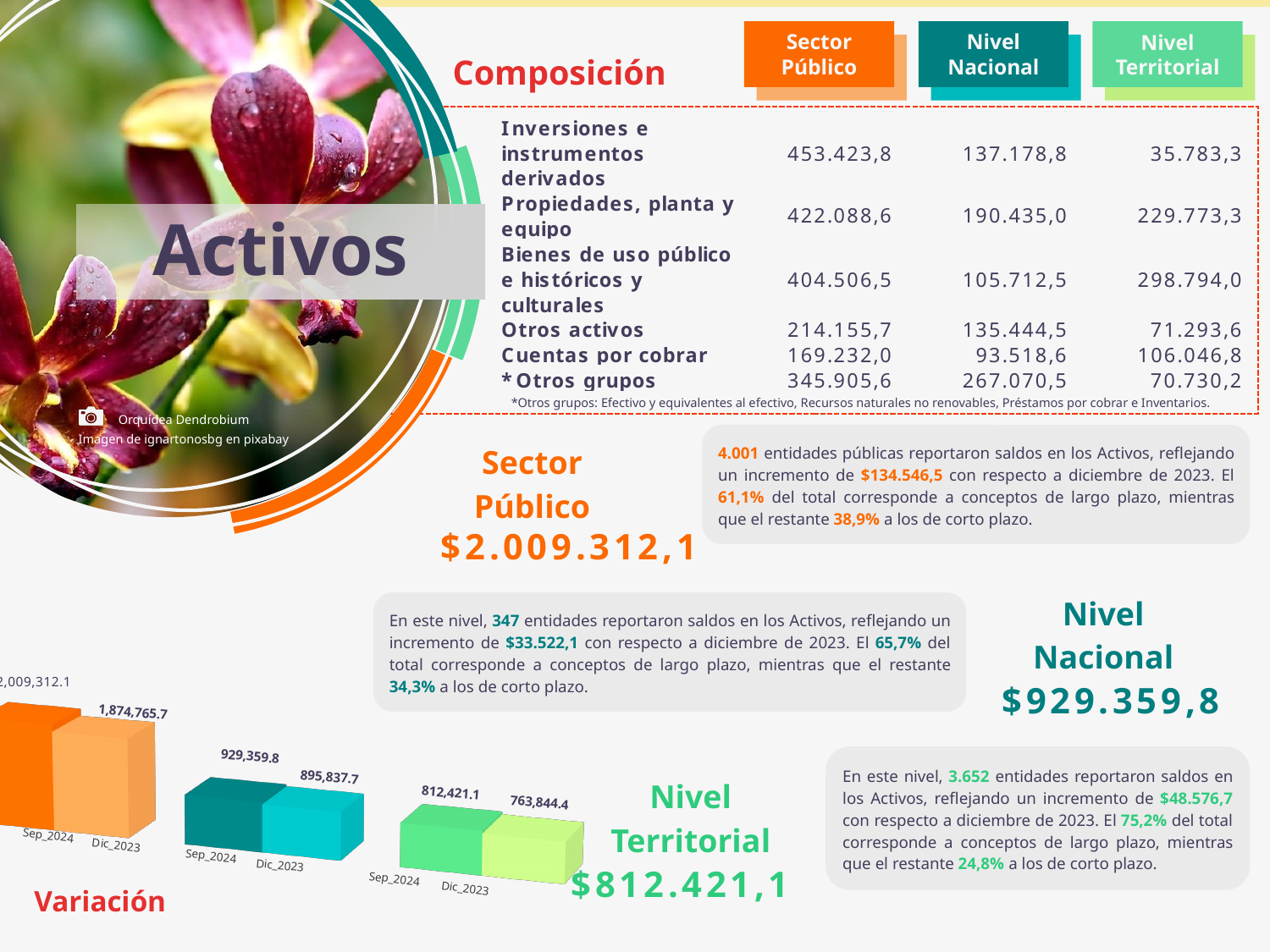
In the middle (teal) bar chart at the bottom of the slide, what is the value for Dic_2023? 895,837.7 How many bars does the middle (teal) chart at the bottom of the slide show? 2 In the middle (teal) bar chart, which period has the higher value, Sep_2024 or Dic_2023? Sep_2024 In the leftmost (orange) bar chart at the bottom of the slide, what is the value for Dic_2023? 1,874,765.7 In the middle (teal) bar chart, what is the difference between the Sep_2024 and Dic_2023 values? 33,522.1 In the rightmost (green) bar chart at the bottom of the slide, what is the value for Dic_2023? 763,844.4 In the middle (teal) bar chart at the bottom of the slide, what is the value for Sep_2024? 929,359.8 In the rightmost (green) bar chart, which period has the lower value? Dic_2023 What type of chart is used in the Variación section at the bottom of the slide? Bar chart In the leftmost (orange) bar chart, which period has the higher value? Sep_2024 In the rightmost (green) bar chart at the bottom of the slide, what is the value for Sep_2024? 812,421.1 In the rightmost (green) bar chart, what is the difference between the Sep_2024 and Dic_2023 values? 48,576.7